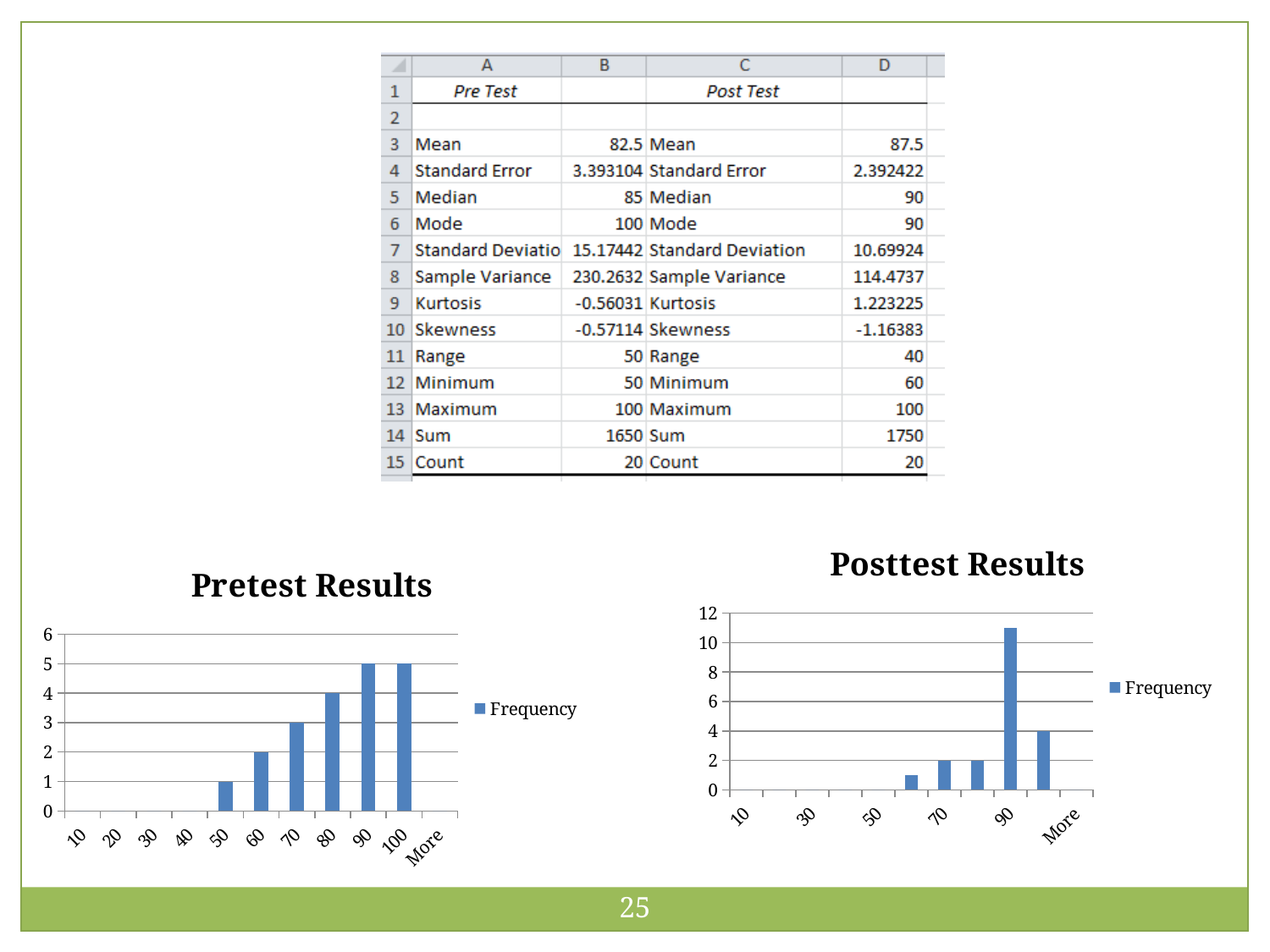
In the Pretest Results chart, what is the frequency for the 50 bin? 1 In the Pretest Results chart, what is the difference between the frequency for 80 and the frequency for 60? 2 In the Pretest Results chart, how many series does the legend list? 1 In the Pretest Results chart, what is the frequency for the 90 bin? 5 In the Posttest Results chart, is the frequency for the 90 bin greater or less than 10? greater In the Posttest Results chart, which bin has the highest frequency? 90 In the Pretest Results chart, do the frequencies rise or fall from the 50 bin to the 90 bin? rise In the Pretest Results chart, what is the frequency for the 70 bin? 3 In the Pretest Results chart, which bin has the higher frequency, 60 or 80? 80 In the Pretest Results chart, what kind of chart is shown? bar chart In the Posttest Results chart, what is the frequency for the 70 bin? 2 In the Pretest Results chart, how many bins are shown on the x axis? 11